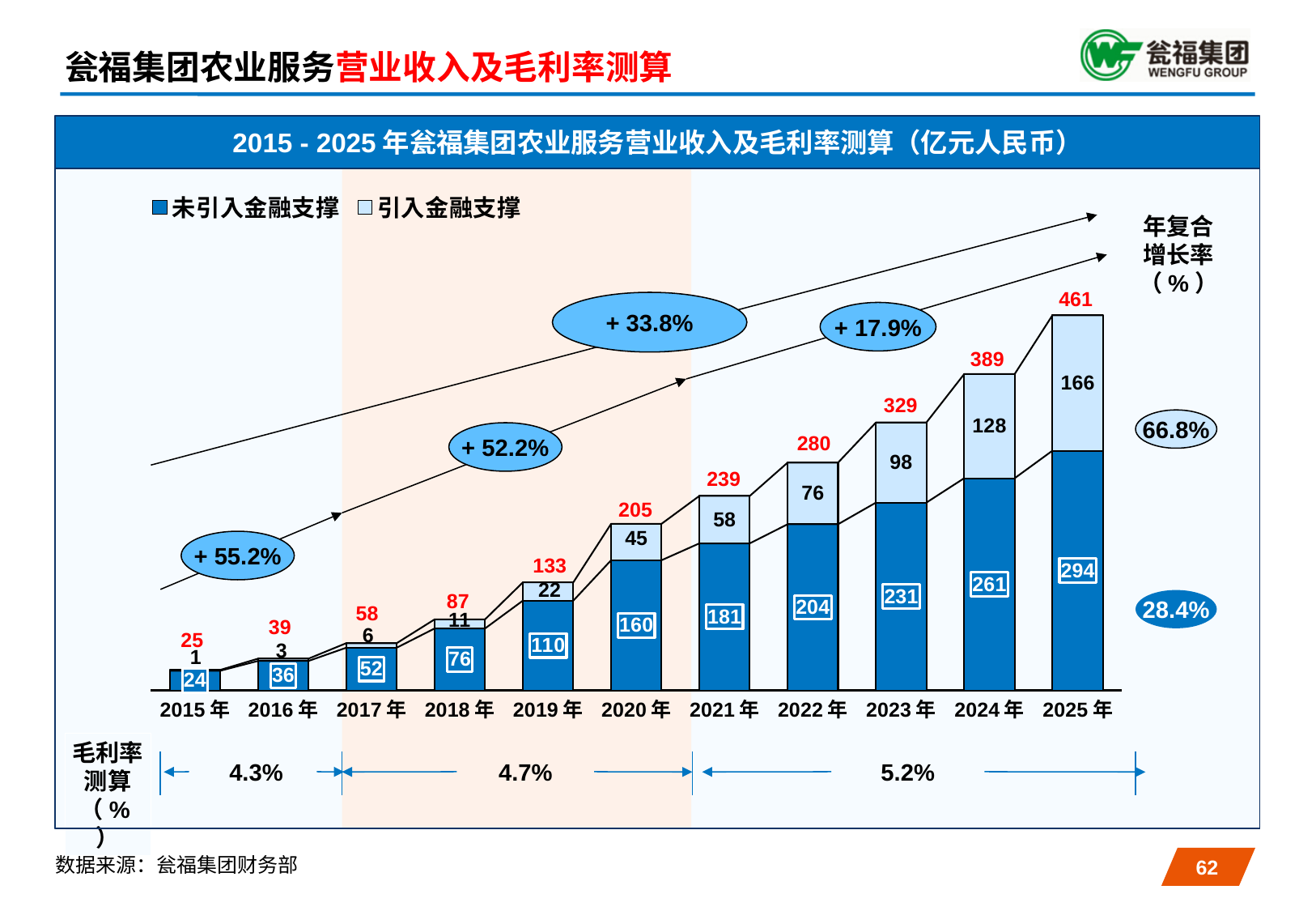
Which is larger: the 引入金融支撑 value for 2022 年 or the 引入金融支撑 value for 2021 年? 2022 年 Which year has the lowest total value? 2015 年 What is the value of 引入金融支撑 for 2024 年? 128 What is the total (red label) shown above the bar for 2023 年? 329 What kind of chart is this? Stacked bar chart Which year has the highest total value? 2025 年 What is the value of 未引入金融支撑 for 2020 年? 160 How many years are shown on the x axis? 11 What is the difference between the 未引入金融支撑 values for 2025 年 and 2024 年? 33 What is the total of the stacked bar for 2019 年 (110 + 22)? 133 Do the total values rise or fall from 2015 年 to 2025 年? Rise How many series does the legend list? 2